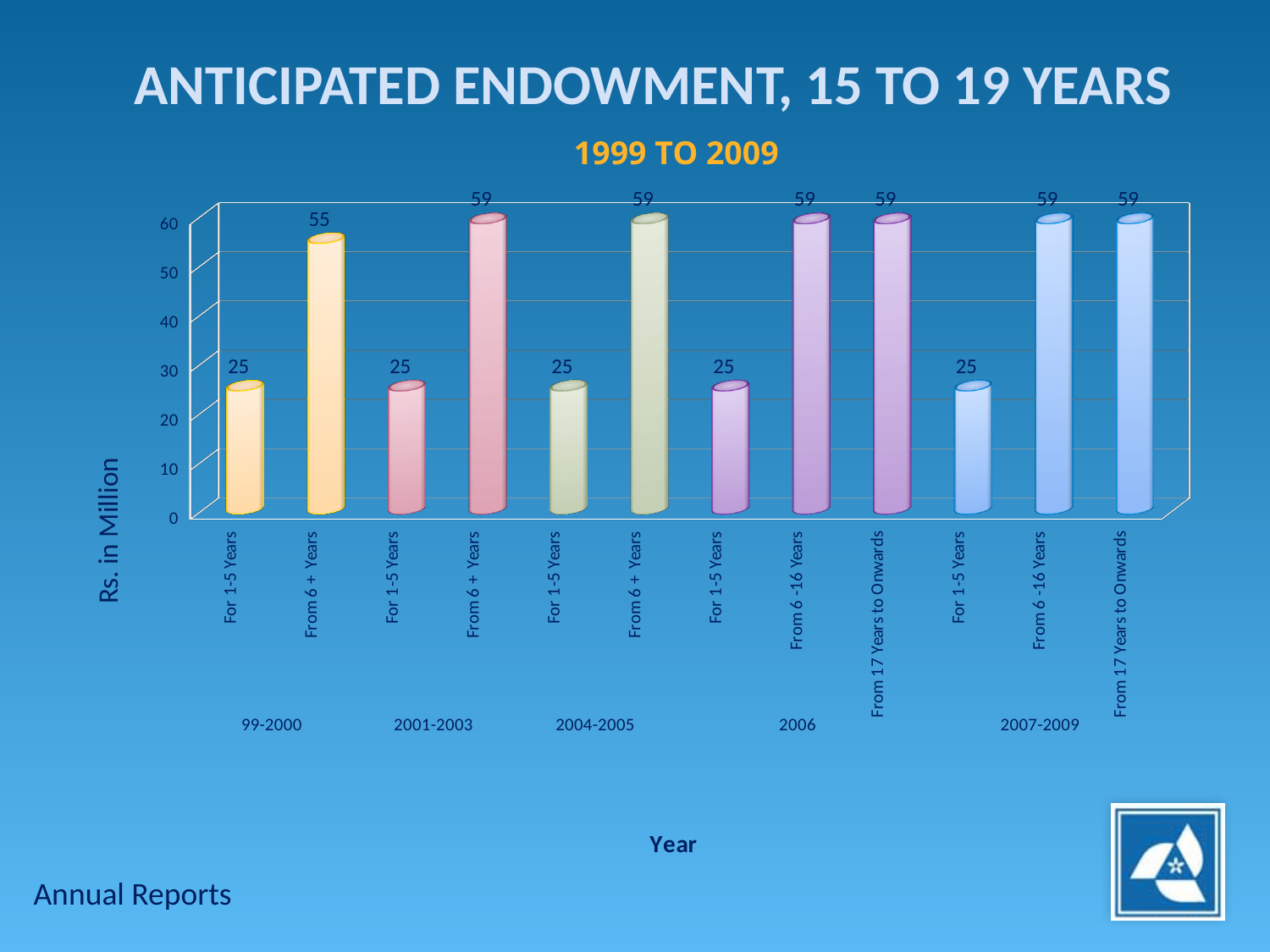
What is the difference between 'From 6 + Years' and 'For 1-5 Years' in the 99-2000 group? 30 Which is larger: 'For 1-5 Years' in 2004-2005 or 'From 6 + Years' in 2004-2005? From 6 + Years What is the value for 'From 6 -16 Years' in the 2007-2009 group? 59 What is the value for 'From 6 + Years' in the 99-2000 group? 55 What is the label of the vertical axis? Rs. in Million What kind of chart is shown on the slide? Bar chart What is the highest value shown on the chart? 59 How many bars are plotted on the chart? 12 What is the value for 'From 17 Years to Onwards' in the 2006 group? 59 What is the value for 'For 1-5 Years' in the 2001-2003 group? 25 What is the lowest value shown on the chart? 25 What is the difference between 'From 6 + Years' in 2001-2003 and 'From 6 + Years' in 99-2000? 4